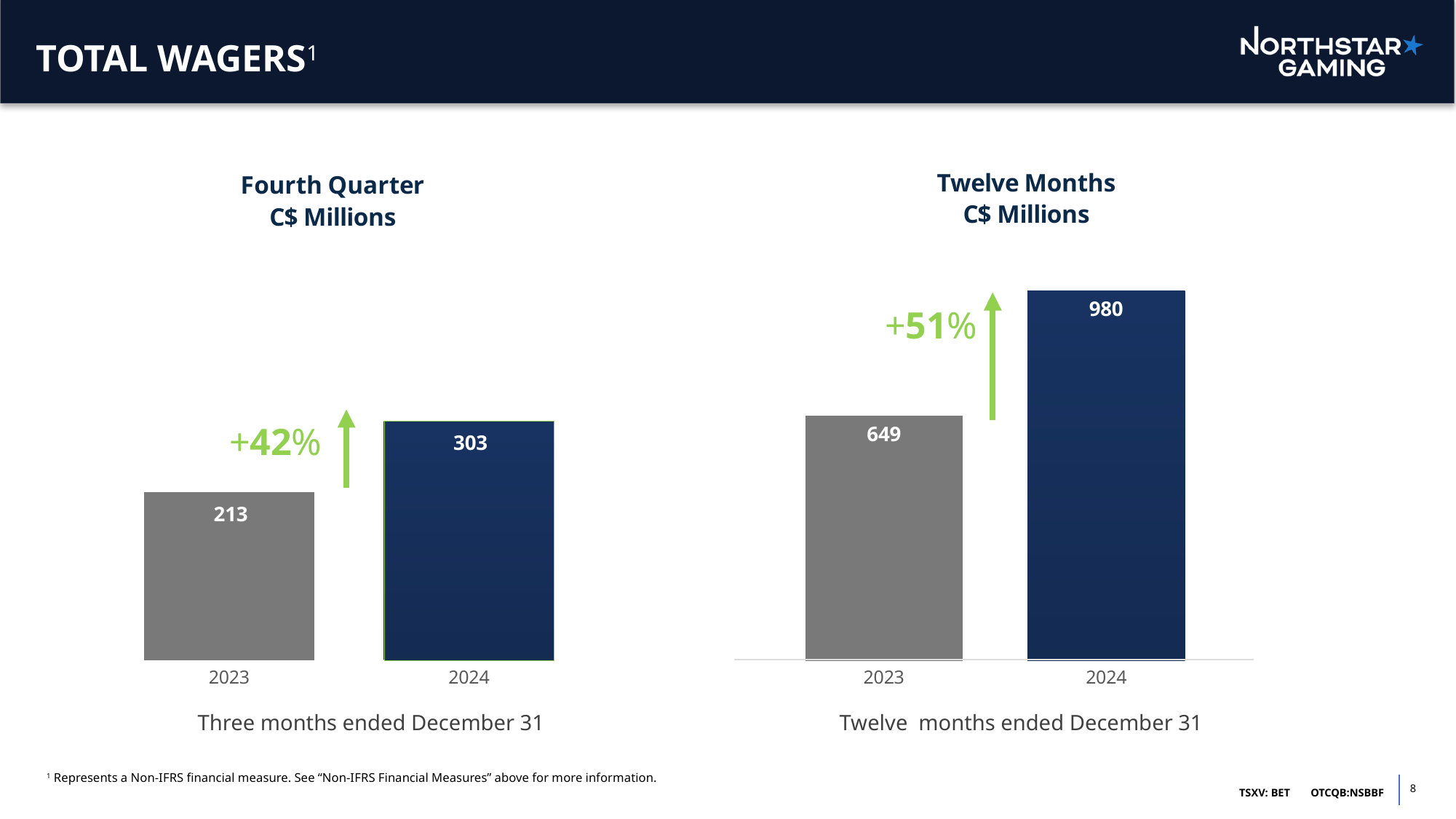
In the Twelve Months chart, what is the value for 2024? 980 In the Twelve Months chart, what percentage change is shown between 2023 and 2024? +51% In the Twelve Months chart, what is the difference between the 2024 and 2023 values? 331 In the Fourth Quarter chart, what is the value for 2023? 213 In the Twelve Months chart, what is the value for 2023? 649 In the Fourth Quarter chart, which year has the lower value? 2023 In the Fourth Quarter chart, what is the value for 2024? 303 In the Fourth Quarter chart, how many bars are plotted? 2 In the Fourth Quarter chart, what is the difference between the 2024 and 2023 values? 90 In the Fourth Quarter chart, what percentage change is shown between 2023 and 2024? +42% What kind of chart is the Twelve Months chart? Bar chart In the Twelve Months chart, which year has the higher value? 2024